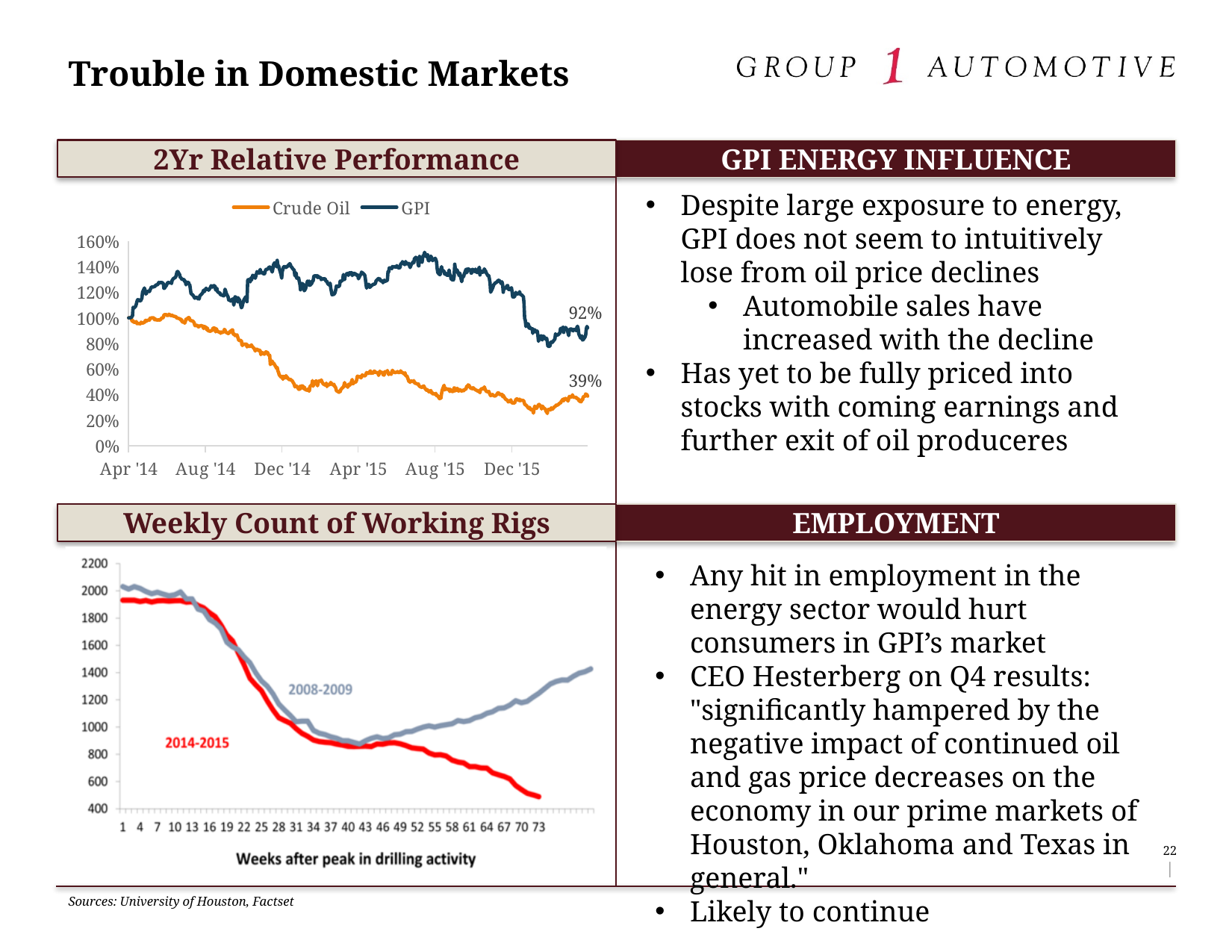
What is the x-axis label of the Weekly Count of Working Rigs chart? Weeks after peak in drilling activity In the 2Yr Relative Performance chart, is the final Crude Oil value greater or less than 40%? less In the Weekly Count of Working Rigs chart, does the 2014-2015 line rise or fall over the weeks shown? Fall In the Weekly Count of Working Rigs chart, which series is higher at week 73, 2008-2009 or 2014-2015? 2008-2009 In the 2Yr Relative Performance chart, what is the final value shown for GPI? 92% In the 2Yr Relative Performance chart, does the Crude Oil line generally rise or fall from Apr '14 to Dec '15? Fall What kind of chart is the 2Yr Relative Performance chart? Line chart In the 2Yr Relative Performance chart, what is the difference between the final GPI value and the final Crude Oil value? 53% In the 2Yr Relative Performance chart, which series ends higher, Crude Oil or GPI? GPI How many series does the legend of the 2Yr Relative Performance chart list? 2 In the Weekly Count of Working Rigs chart, is the 2014-2015 value at week 73 greater or less than 600? less In the 2Yr Relative Performance chart, what is the final value shown for Crude Oil? 39%